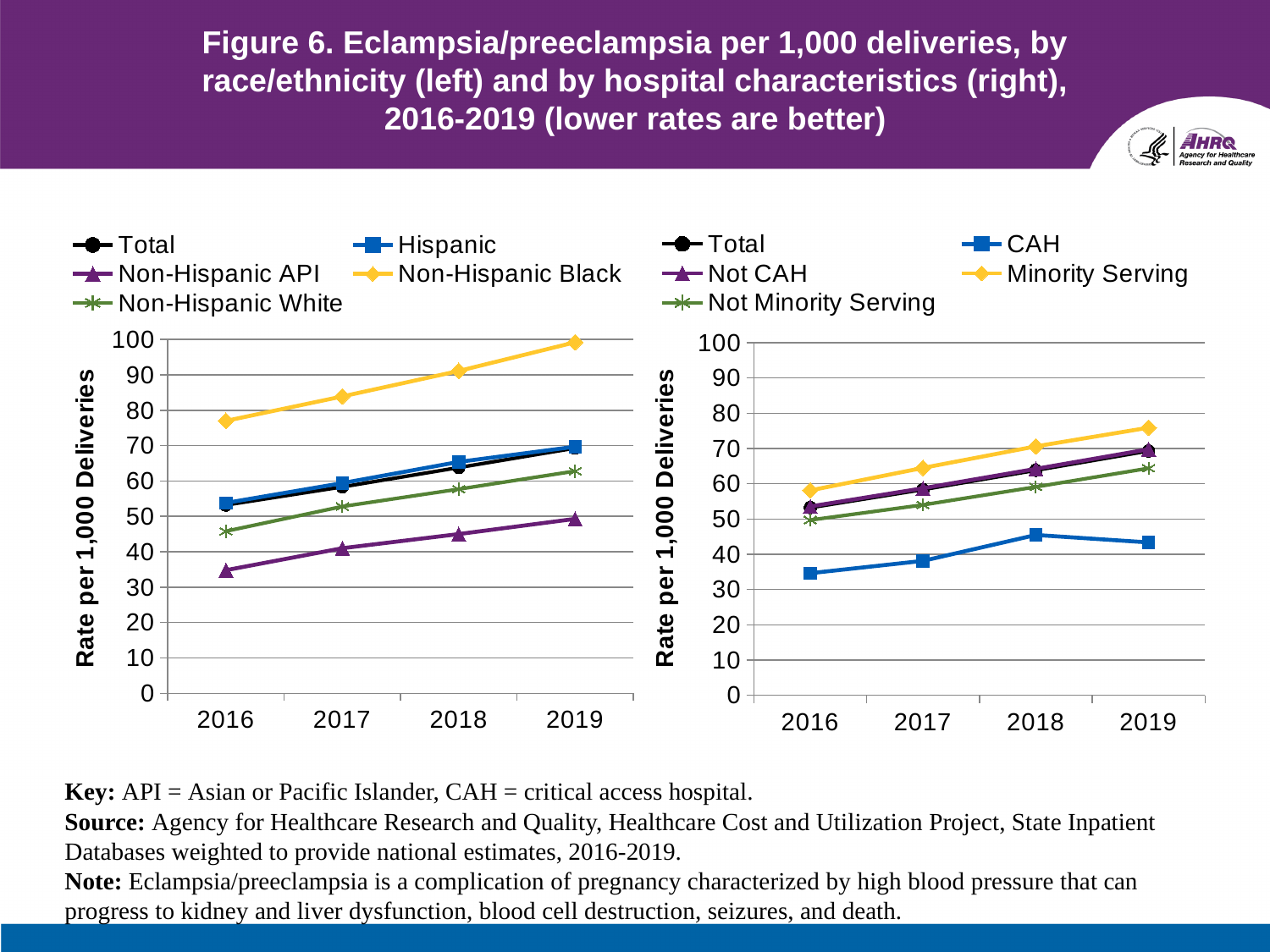
In the right chart (by hospital characteristics), which series has the lowest rate in 2019? CAH In the left chart (by race/ethnicity), does the Non-Hispanic White rate rise or fall from 2016 to 2019? Rise How many series does the legend of the right chart (by hospital characteristics) list? 5 In the right chart (by hospital characteristics), is the value for Minority Serving in 2019 greater or less than 70? greater In the right chart (by hospital characteristics), which series has the highest rate in 2018? Minority Serving In the left chart (by race/ethnicity), is the value for Non-Hispanic Black in 2016 greater or less than 70? greater What kind of chart is the left chart (by race/ethnicity)? Line chart In the left chart (by race/ethnicity), which series has the lowest rate in 2016? Non-Hispanic API In the left chart (by race/ethnicity), is the value for Non-Hispanic API in 2016 greater or less than 40? less How many series does the legend of the left chart (by race/ethnicity) list? 5 In the left chart (by race/ethnicity), which series has the highest rate in 2019? Non-Hispanic Black How many years are plotted along the x axis of the right chart (by hospital characteristics)? 4